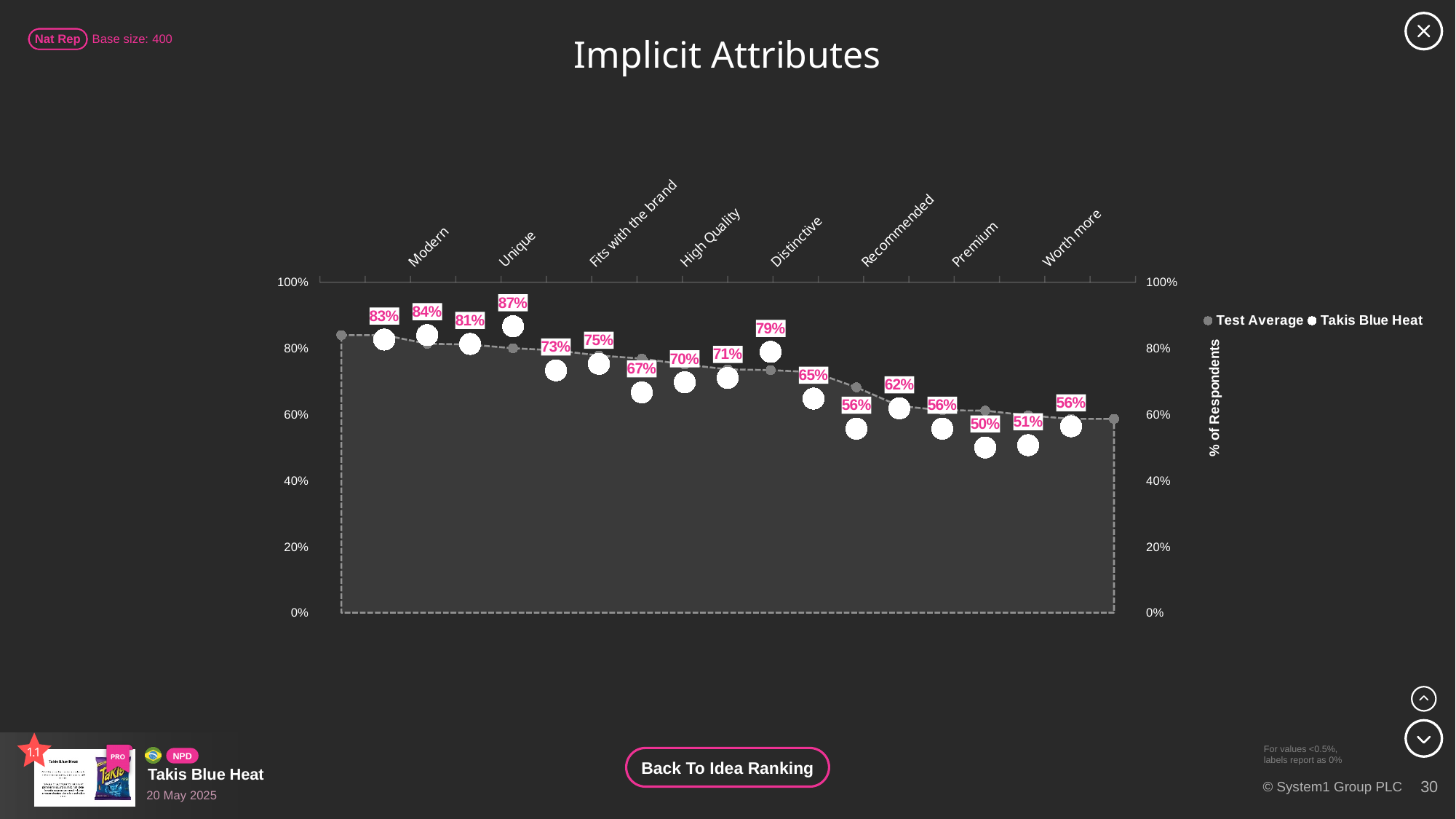
How many Takis Blue Heat data points are labeled with values on the chart? 17 What is the lowest Takis Blue Heat value labeled on the chart? 50% How many attribute labels are written along the top of the chart? 8 What is the title of the chart? Implicit Attributes What are the two series named in the legend? Test Average and Takis Blue Heat What is the difference between the highest (87%) and lowest (50%) Takis Blue Heat values? 37 percentage points What kind of chart is shown? Combination area and line chart Do the Takis Blue Heat values generally rise or fall from left to right along the x axis? Fall Is the leftmost Test Average point greater or less than 80%? greater What is the highest Takis Blue Heat value labeled on the chart? 87% How many Takis Blue Heat data points are labeled 56%? 3 How many series does the legend list? 2